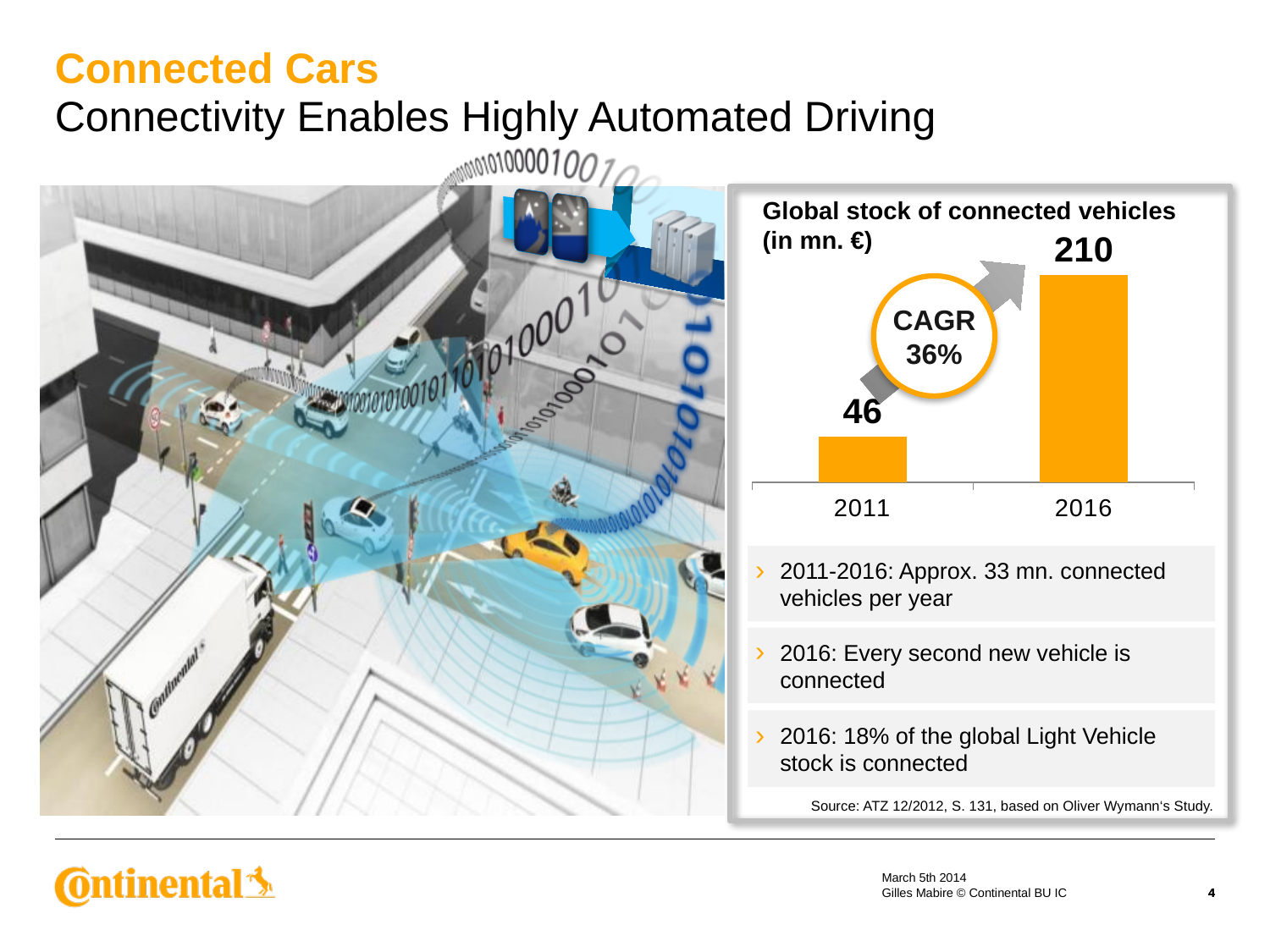
What is the value for 2011 in the chart? 46 What is the value for 2016 in the chart? 210 Is the value for 2016 larger or smaller than the value for 2011? larger What kind of chart is shown on the slide? bar chart What is the title of the chart? Global stock of connected vehicles (in mn. €) Do the values rise or fall from 2011 to 2016? rise What is the difference between the 2016 and 2011 values in the chart? 164 Which year has the lower value in the chart? 2011 What CAGR is shown on the chart? 36% How many years are shown in the chart? 2 Which year has the higher value in the chart? 2016